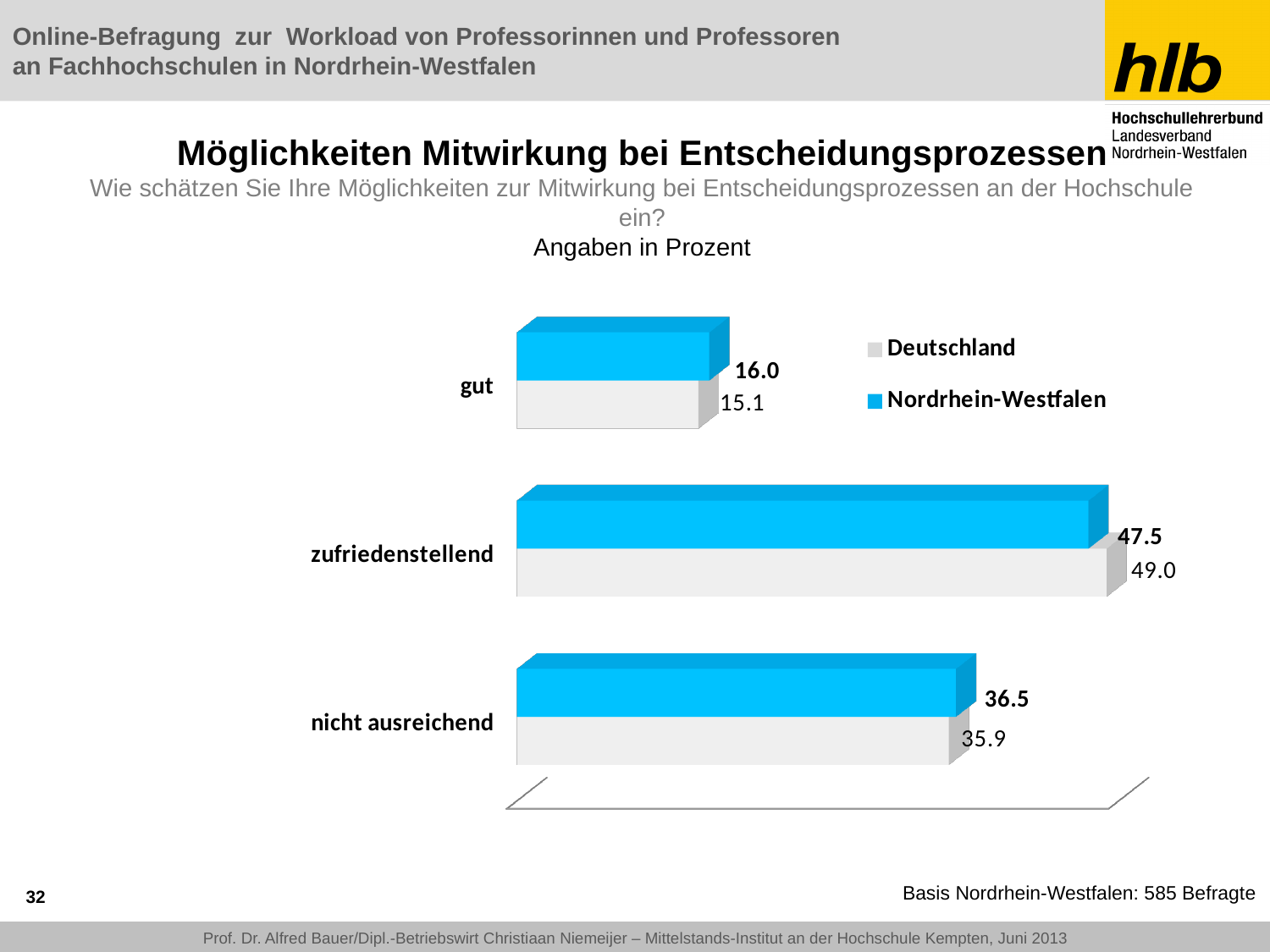
What is the value for Deutschland in the category "gut"? 15.1 What is the value for Nordrhein-Westfalen in the category "gut"? 16.0 For the category "zufriedenstellend", which series has the larger value, Deutschland or Nordrhein-Westfalen? Deutschland What kind of chart is shown on the slide? Bar chart Which category has the highest value for Nordrhein-Westfalen? zufriedenstellend What is the difference between the Deutschland and Nordrhein-Westfalen values for "zufriedenstellend"? 1.5 What is the value for Deutschland in the category "zufriedenstellend"? 49.0 What is the difference between the Nordrhein-Westfalen and Deutschland values for "nicht ausreichend"? 0.6 What is the value for Nordrhein-Westfalen in the category "nicht ausreichend"? 36.5 How many series does the legend list? 2 How many categories are shown in the chart? 3 Which category has the lowest value for Deutschland? gut